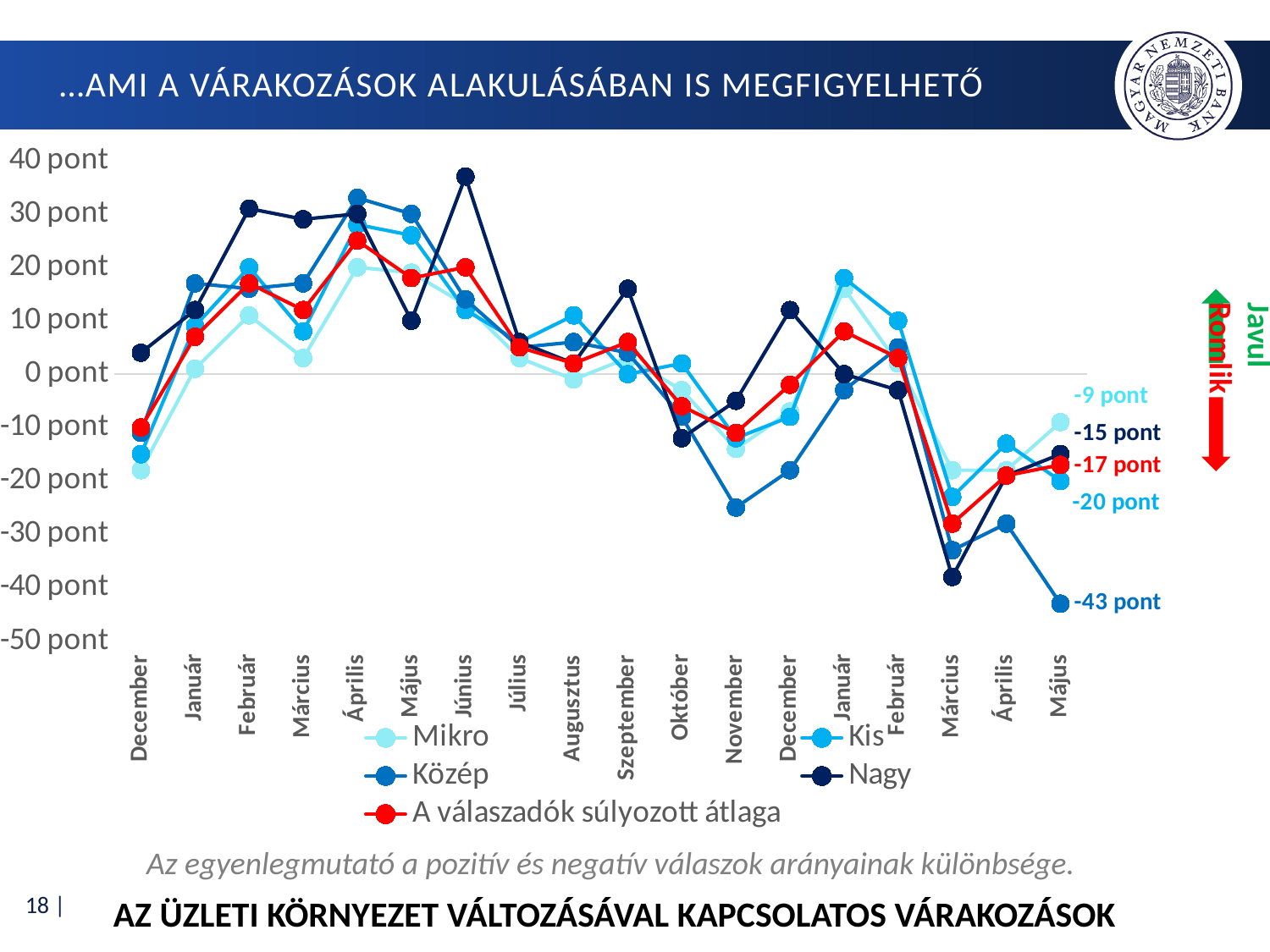
What is the value for A válaszadók súlyozott átlaga in the final Május? -17 pont How many series does the legend list? 5 What kind of chart is shown on the slide? line chart Which series has the lowest value in the final Május? Közép What colour is the line for A válaszadók súlyozott átlaga? red What is the value for Közép in the final Május? -43 pont What is the difference between the Mikro and Közép values in the final Május? 34 pont Is the value for Nagy in Június greater or less than 30 pont? greater What is the value for Mikro in the final Május? -9 pont How many months are shown along the x axis? 18 In the final Május, which is larger: the value for Nagy or the value for Kis? Nagy Which series has the highest value in the final Május? Mikro